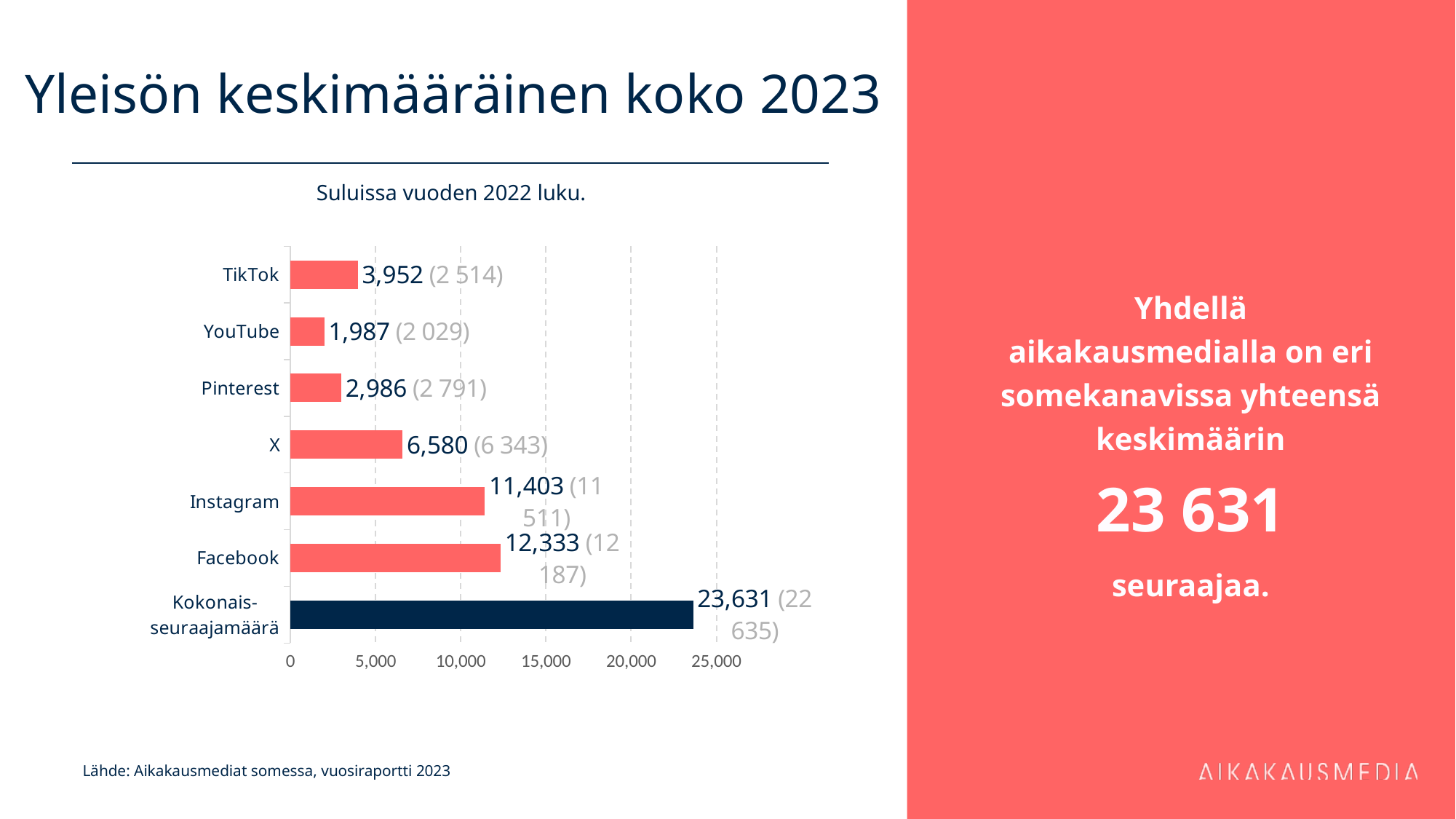
What is the title of the slide? Yleisön keskimääräinen koko 2023 What is the difference between the 2023 values for Facebook and Instagram? 930 What kind of chart is shown on the slide? Bar chart How many categories are shown in the chart? 7 Is the value for Instagram greater or less than 10,000? greater What is the 2023 value for TikTok? 3,952 What is the 2023 value for Facebook? 12,333 Which individual social media channel has the lowest 2023 value? YouTube Which has a larger 2023 value, X or Pinterest? X Which category has the highest value in the chart? Kokonais-seuraajamäärä What is the value for Kokonais-seuraajamäärä? 23,631 What is the 2022 value shown in parentheses for Instagram? 11 511